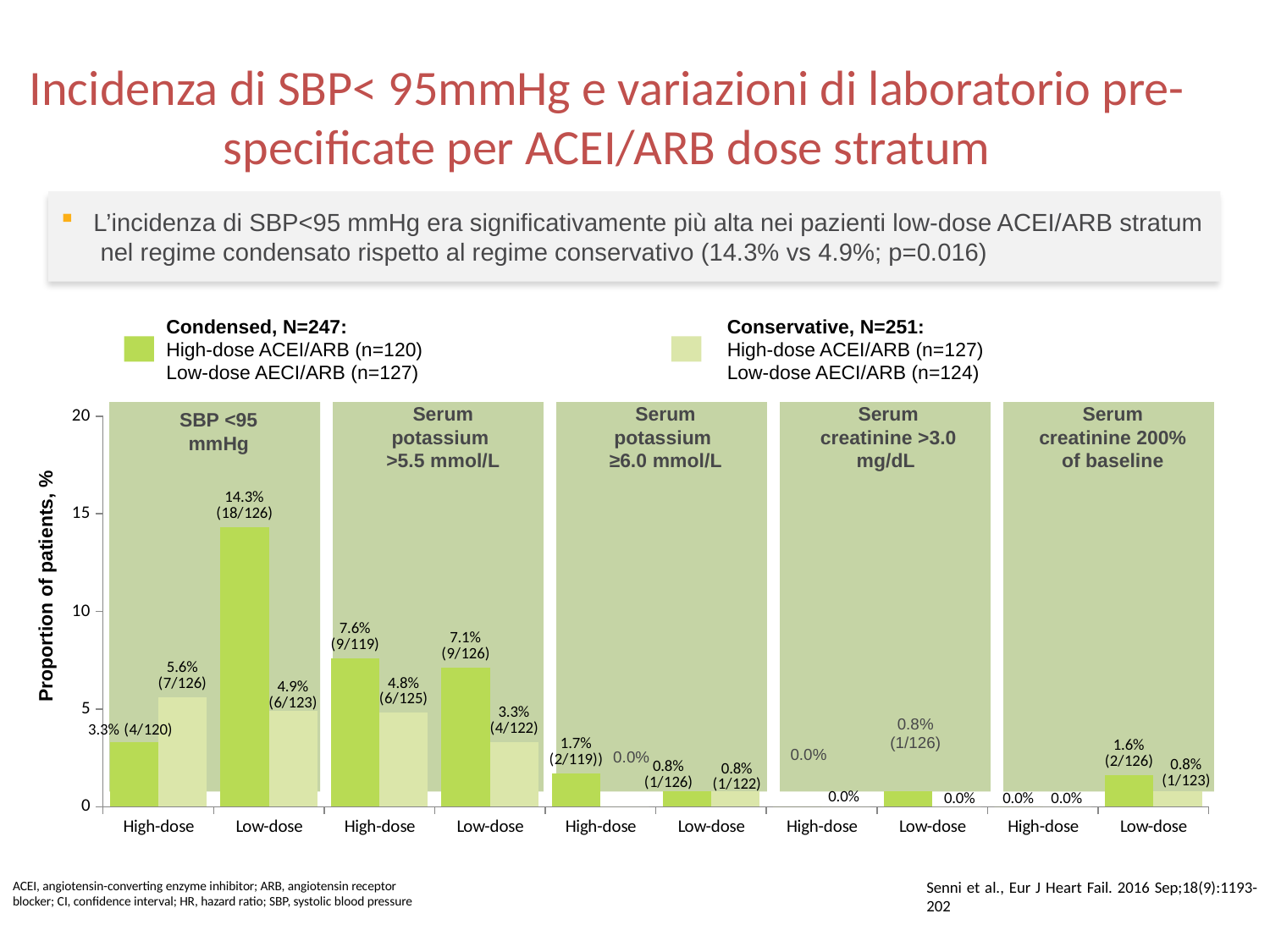
For high-dose patients with SBP <95 mmHg, which regimen has the larger proportion, Condensed or Conservative? Conservative What is the proportion of patients with SBP <95 mmHg in the low-dose ACEI/ARB stratum of the Condensed regimen? 14.3% What is the proportion of patients with SBP <95 mmHg in the low-dose stratum of the Conservative regimen? 4.9% What is the difference between the Condensed and Conservative low-dose proportions for SBP <95 mmHg? 9.4% How many outcome panels are shown in the chart? 5 What is the label of the y axis? Proportion of patients, % Which bar in the chart shows the highest proportion of patients? Low-dose Condensed, SBP <95 mmHg (14.3%) What is the proportion of high-dose Condensed patients with serum potassium >5.5 mmol/L? 7.6% What type of chart is shown on the slide? bar chart How many series does the legend list? 2 What is the proportion of low-dose Conservative patients with serum potassium >5.5 mmol/L? 3.3% What is the proportion of low-dose Condensed patients with serum creatinine 200% of baseline? 1.6%